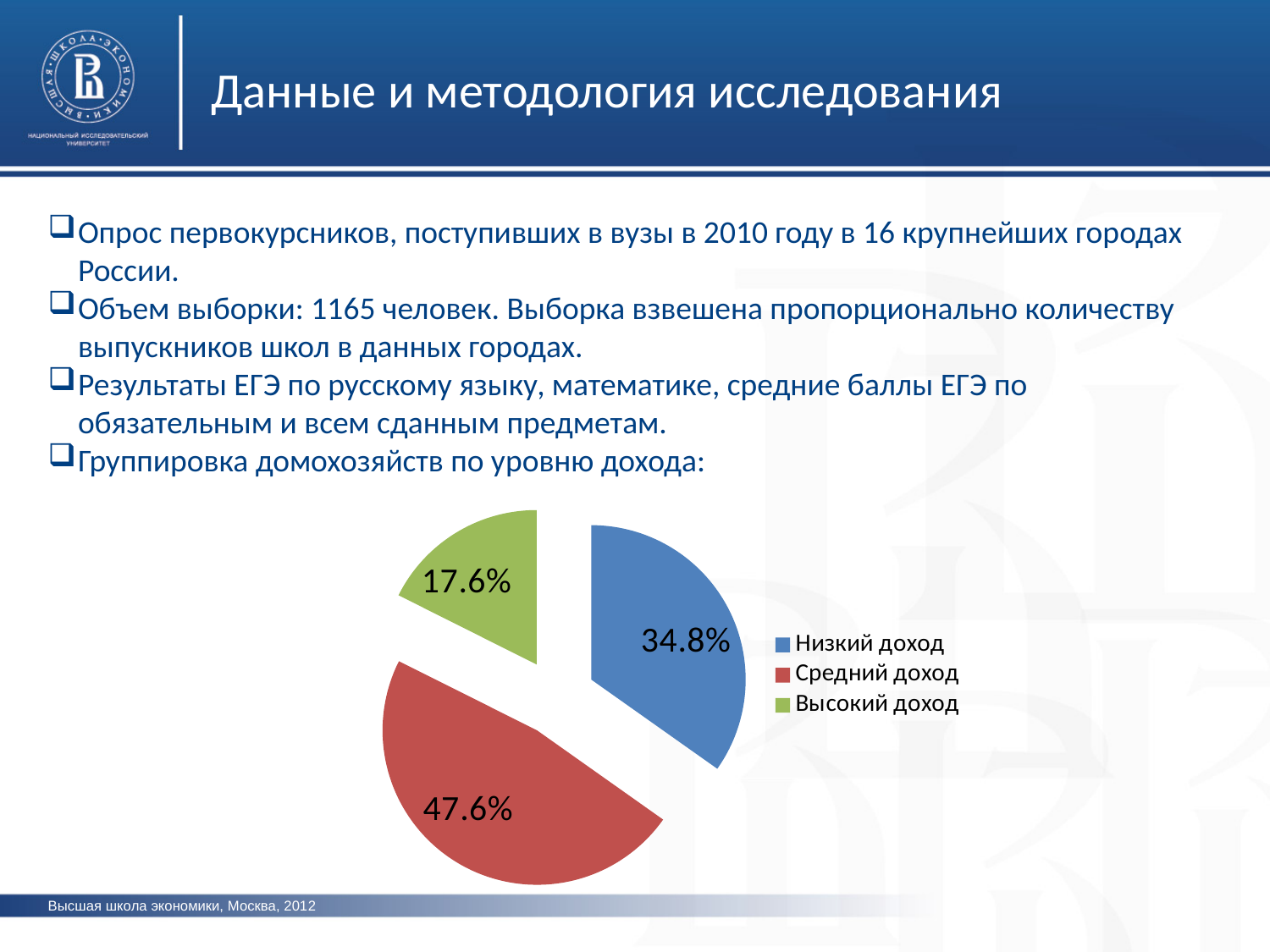
What share of the pie chart is labelled Низкий доход? 34.8% What is the difference in percentage points between the Средний доход and Низкий доход slices? 12.8 What share of the pie chart is labelled Средний доход? 47.6% What colour is the Средний доход slice in the pie chart? red What share of the pie chart is labelled Высокий доход? 17.6% What kind of chart is shown on the slide? pie chart How many entries does the legend of the pie chart list? 3 Which income group has the smallest slice of the pie chart? Высокий доход How many slices does the pie chart have? 3 What is the difference in percentage points between the Низкий доход and Высокий доход slices? 17.2 Which income group has the largest slice of the pie chart? Средний доход Which slice is larger, Низкий доход or Высокий доход? Низкий доход